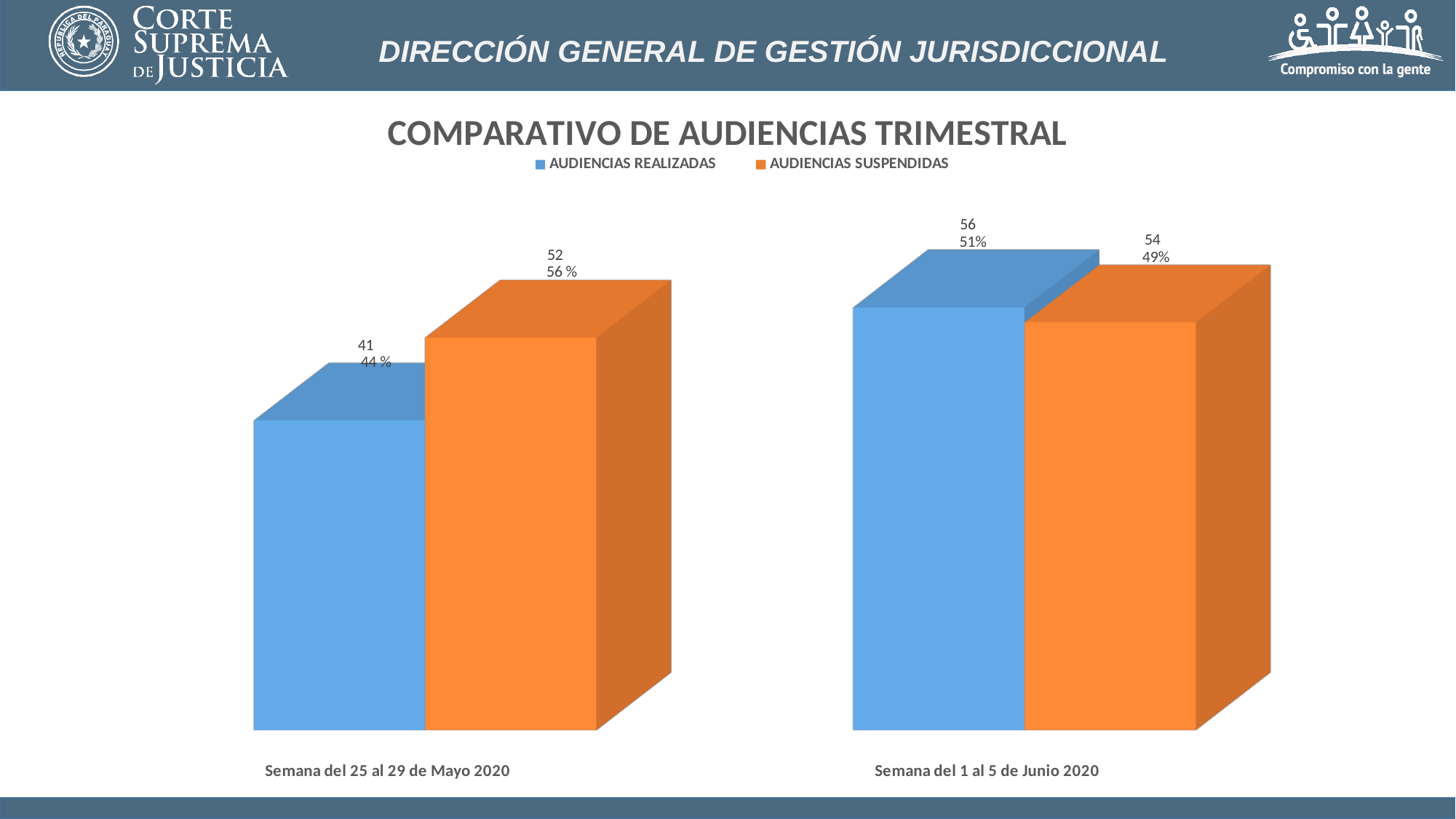
How many series does the legend list? 2 What kind of chart is shown on the slide? Bar chart Which series has the higher value for Semana del 25 al 29 de Mayo 2020? AUDIENCIAS SUSPENDIDAS What is the value of AUDIENCIAS REALIZADAS for Semana del 25 al 29 de Mayo 2020? 41 What percentage is shown for AUDIENCIAS SUSPENDIDAS in Semana del 25 al 29 de Mayo 2020? 56 % What is the title of the chart? COMPARATIVO DE AUDIENCIAS TRIMESTRAL What is the value of AUDIENCIAS SUSPENDIDAS for Semana del 1 al 5 de Junio 2020? 54 Which week has the higher value for AUDIENCIAS REALIZADAS? Semana del 1 al 5 de Junio 2020 What is the difference between AUDIENCIAS SUSPENDIDAS and AUDIENCIAS REALIZADAS for Semana del 25 al 29 de Mayo 2020? 11 What percentage is shown for AUDIENCIAS REALIZADAS in Semana del 1 al 5 de Junio 2020? 51% What is the value of AUDIENCIAS REALIZADAS for Semana del 1 al 5 de Junio 2020? 56 What is the value of AUDIENCIAS SUSPENDIDAS for Semana del 25 al 29 de Mayo 2020? 52